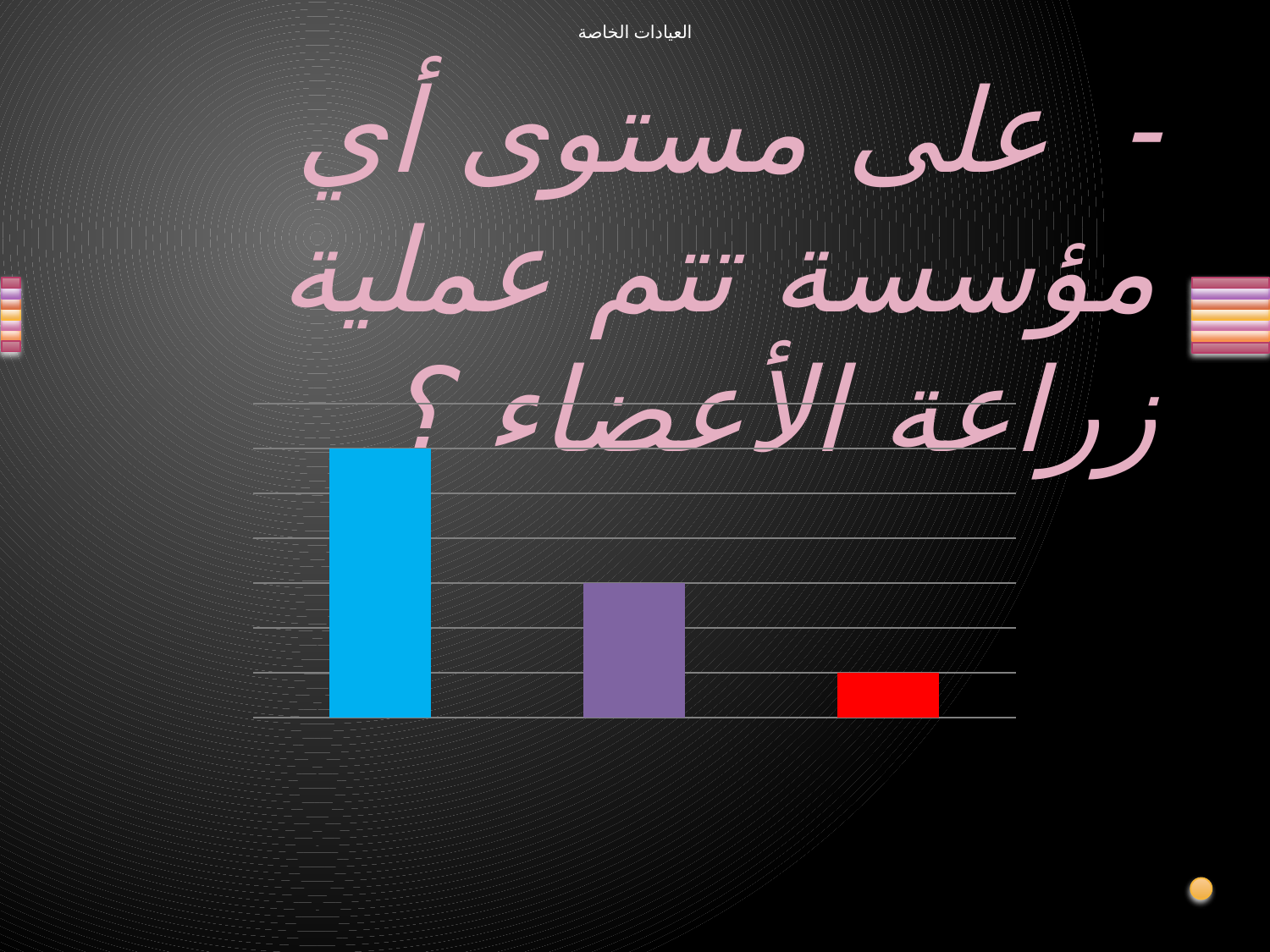
How many bars are plotted in the chart? 3 Which position does the tallest bar occupy in the chart: leftmost, middle or rightmost? leftmost Which position does the shortest bar occupy in the chart: leftmost, middle or rightmost? rightmost Does the chart display a legend? No Which bar is the tallest in the chart: the blue, the purple or the red one? the blue bar Which is taller in the chart, the blue bar or the purple bar? the blue bar What colour is the middle bar in the chart? purple Do the bar heights rise or fall from left to right across the chart? fall Which bar is the shortest in the chart: the blue, the purple or the red one? the red bar What kind of chart is shown on the slide? bar chart Which is taller in the chart, the purple bar or the red bar? the purple bar